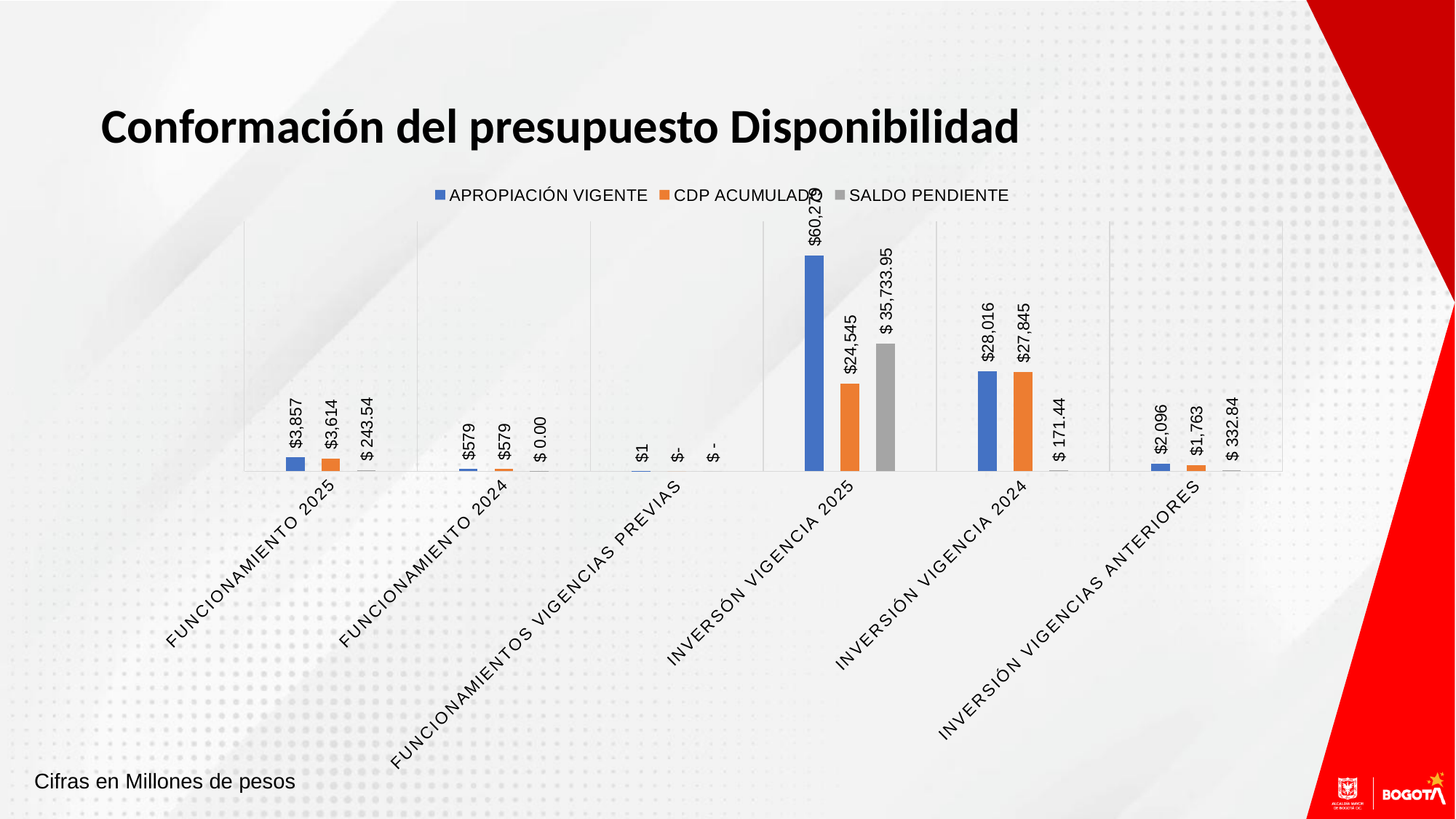
How many series does the legend list? 3 What kind of chart is shown on the slide? bar chart What is the SALDO PENDIENTE value for INVERSIÓN VIGENCIAS ANTERIORES? $ 332.84 What is the APROPIACIÓN VIGENTE value for FUNCIONAMIENTO 2025? $3,857 How many categories are shown on the x axis? 6 What is the difference between the APROPIACIÓN VIGENTE and CDP ACUMULADO values for INVERSIÓN VIGENCIA 2024? $171 Which category has the lowest APROPIACIÓN VIGENTE value? FUNCIONAMIENTOS VIGENCIAS PREVIAS Which category has the highest APROPIACIÓN VIGENTE value? INVERSÓN VIGENCIA 2025 What is the SALDO PENDIENTE value for INVERSÓN VIGENCIA 2025? $ 35,733.95 What is the CDP ACUMULADO value for FUNCIONAMIENTO 2024? $579 Which is larger for INVERSÓN VIGENCIA 2025: the CDP ACUMULADO value or the SALDO PENDIENTE value? SALDO PENDIENTE What is the CDP ACUMULADO value for INVERSIÓN VIGENCIA 2024? $27,845